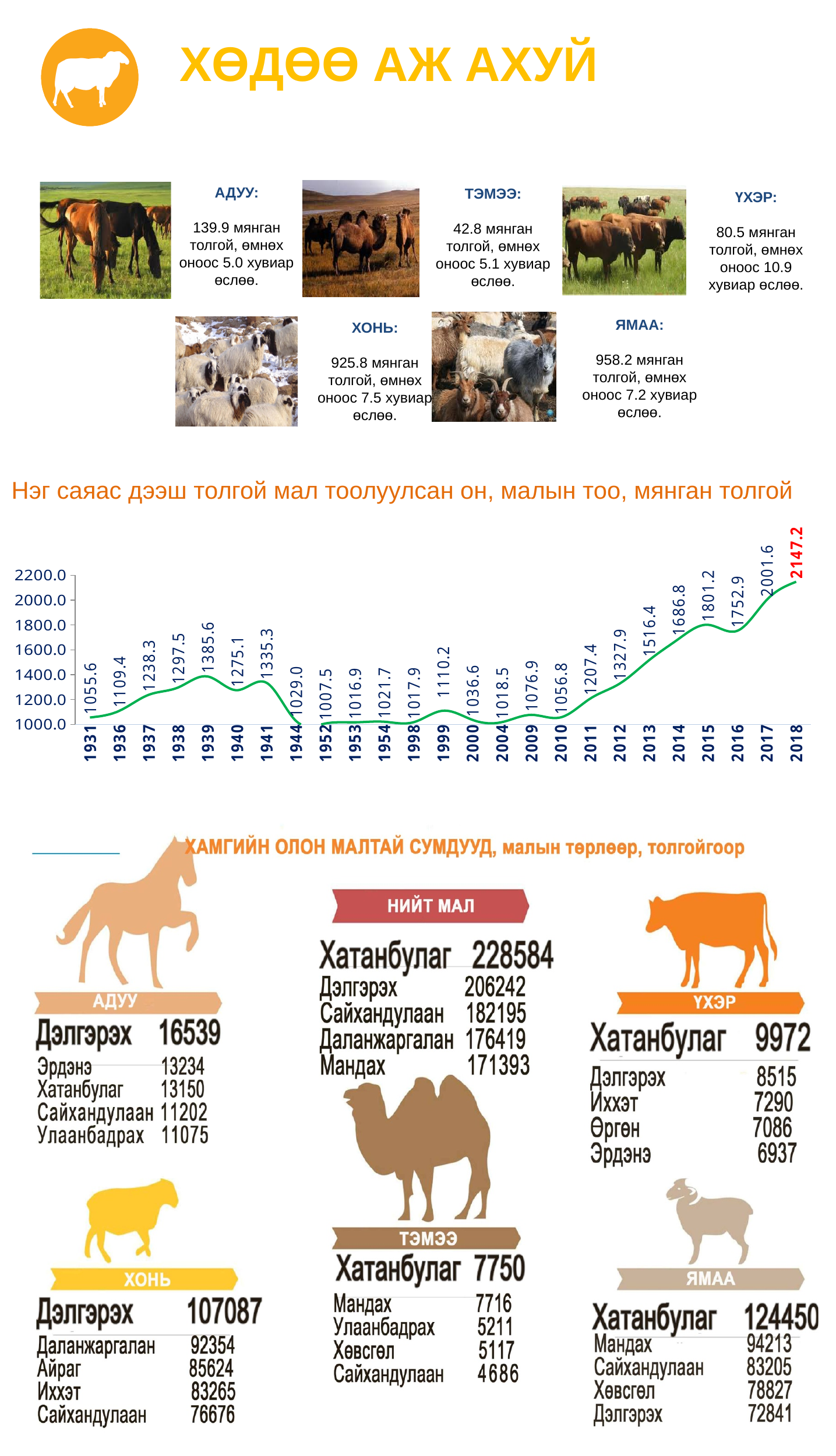
How many years are plotted on the x axis of the line chart? 25 In the line chart, which year has the highest value? 2018 In the line chart, what is the difference between the values for 2015 and 2016? 48.3 In the line chart, what is the difference between the values for 2018 and 2017? 145.6 In the line chart, what is the value for 2018? 2147.2 In the line chart, do the values rise or fall from 2010 to 2015? Rise In the line chart, which year has the larger value, 1939 or 1941? 1939 In the line chart, what is the value for 1939? 1385.6 In the line chart, which year has the lowest value? 1952 In the line chart, is the value for 2013 greater or less than 1400.0? greater What kind of chart is shown under the title "Нэг саяас дээш толгой мал тоолуулсан он, малын тоо, мянган толгой"? Line chart In the line chart, what is the value for 2011? 1207.4